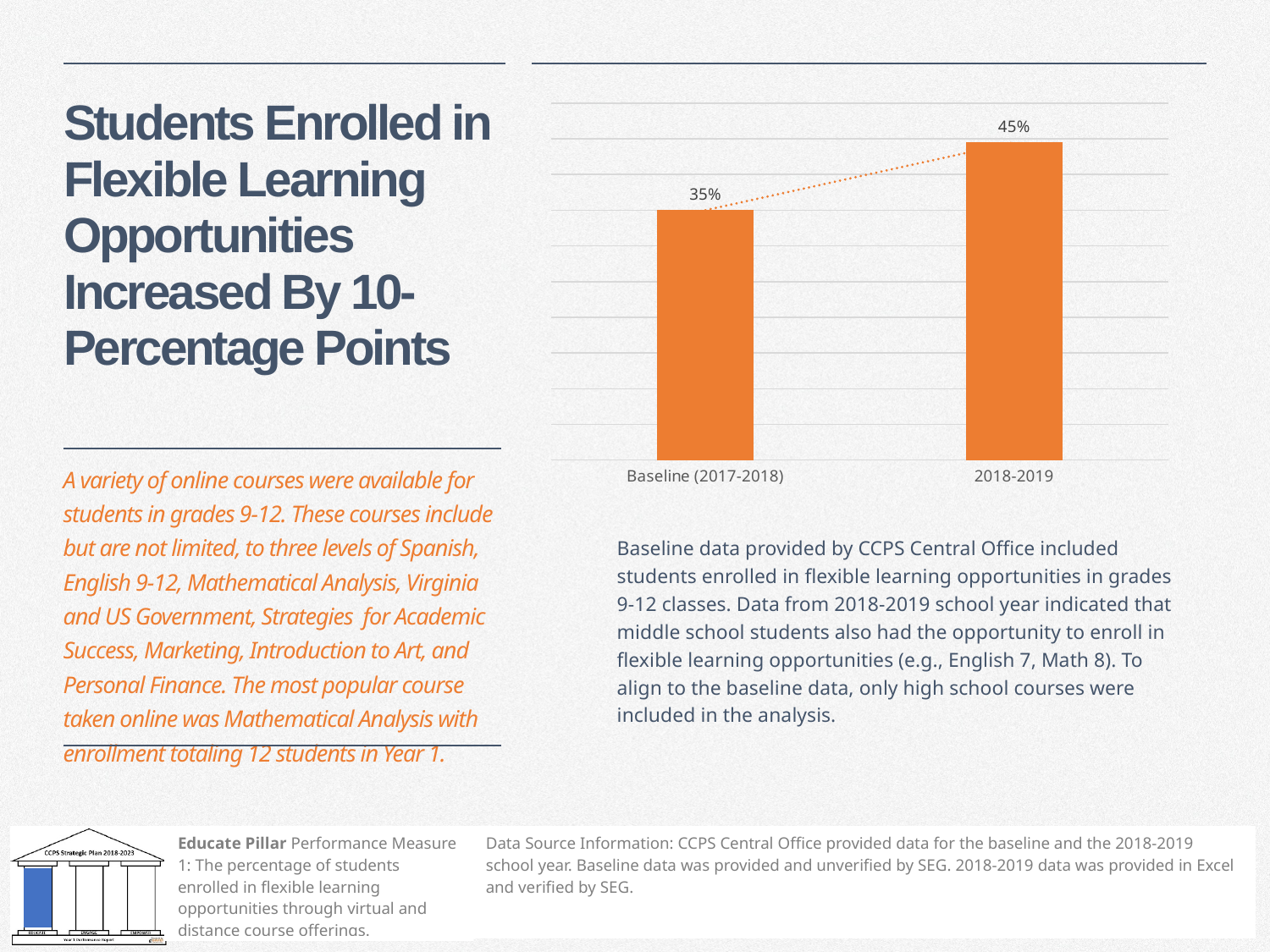
What is the value for 2018-2019? 45% Which is larger, the value for Baseline (2017-2018) or the value for 2018-2019? 2018-2019 Do the values rise or fall from Baseline (2017-2018) to 2018-2019? Rise Which category has the lowest value? Baseline (2017-2018) What is the value for Baseline (2017-2018)? 35% Which category has the highest value? 2018-2019 What is the difference between the 2018-2019 value and the Baseline (2017-2018) value? 10 percentage points How many categories are shown on the x axis? 2 What colour are the bars in the chart? Orange What kind of chart is shown on the slide? Bar chart